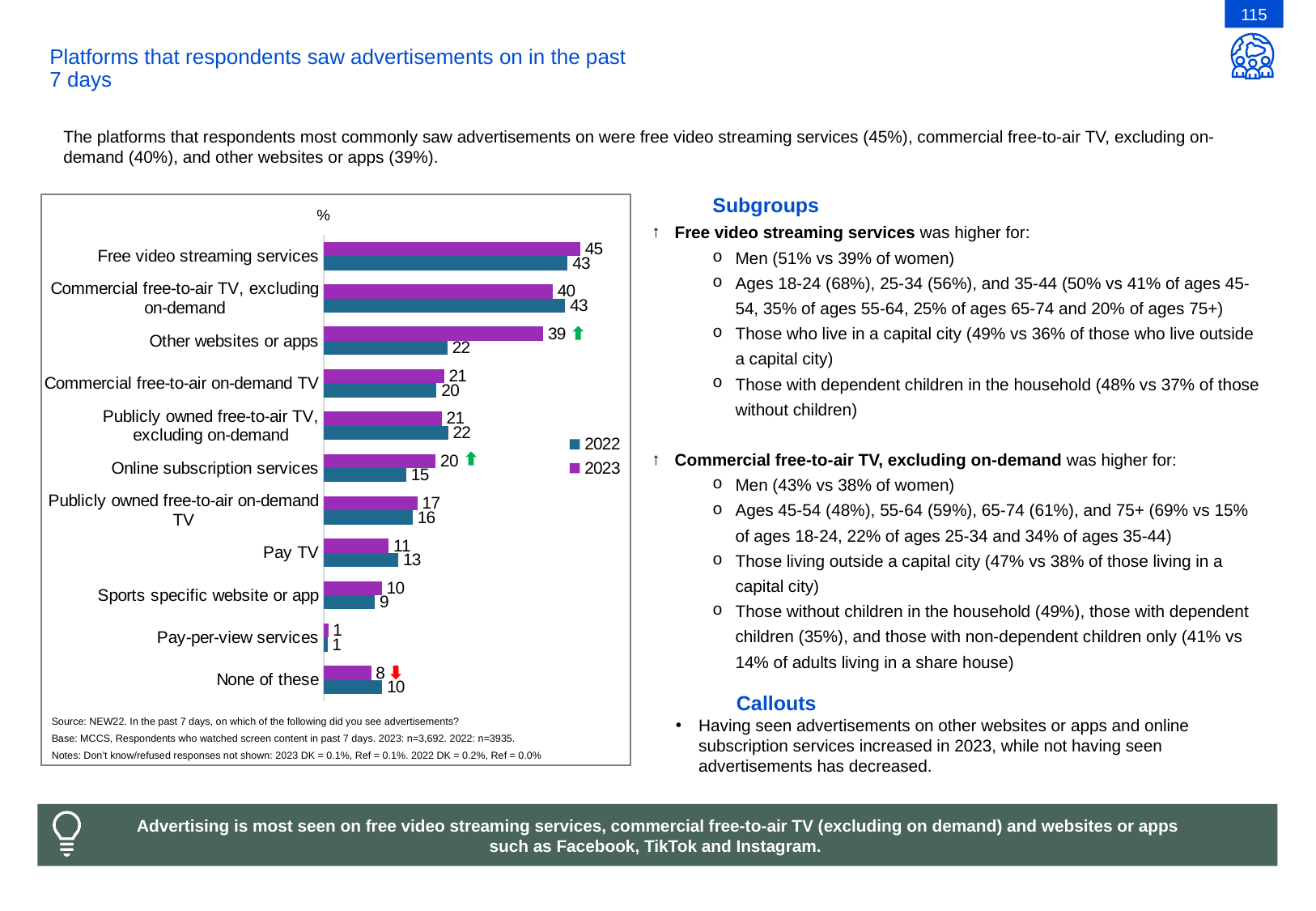
Which category has the lowest 2022 value? Pay-per-view services How many categories are shown in the chart? 11 What is the difference between the 2023 and 2022 values for Other websites or apps? 17 What is the 2023 value for Online subscription services? 20 What is the 2023 value for Free video streaming services? 45 Which colour represents the 2023 series in the chart? Purple What kind of chart is shown on the slide? Bar chart How many series does the legend list? 2 What is the 2022 value for Other websites or apps? 22 Which is larger for Commercial free-to-air TV, excluding on-demand: the 2022 value or the 2023 value? 2022 What is the 2022 value for None of these? 10 Which category has the highest 2023 value? Free video streaming services